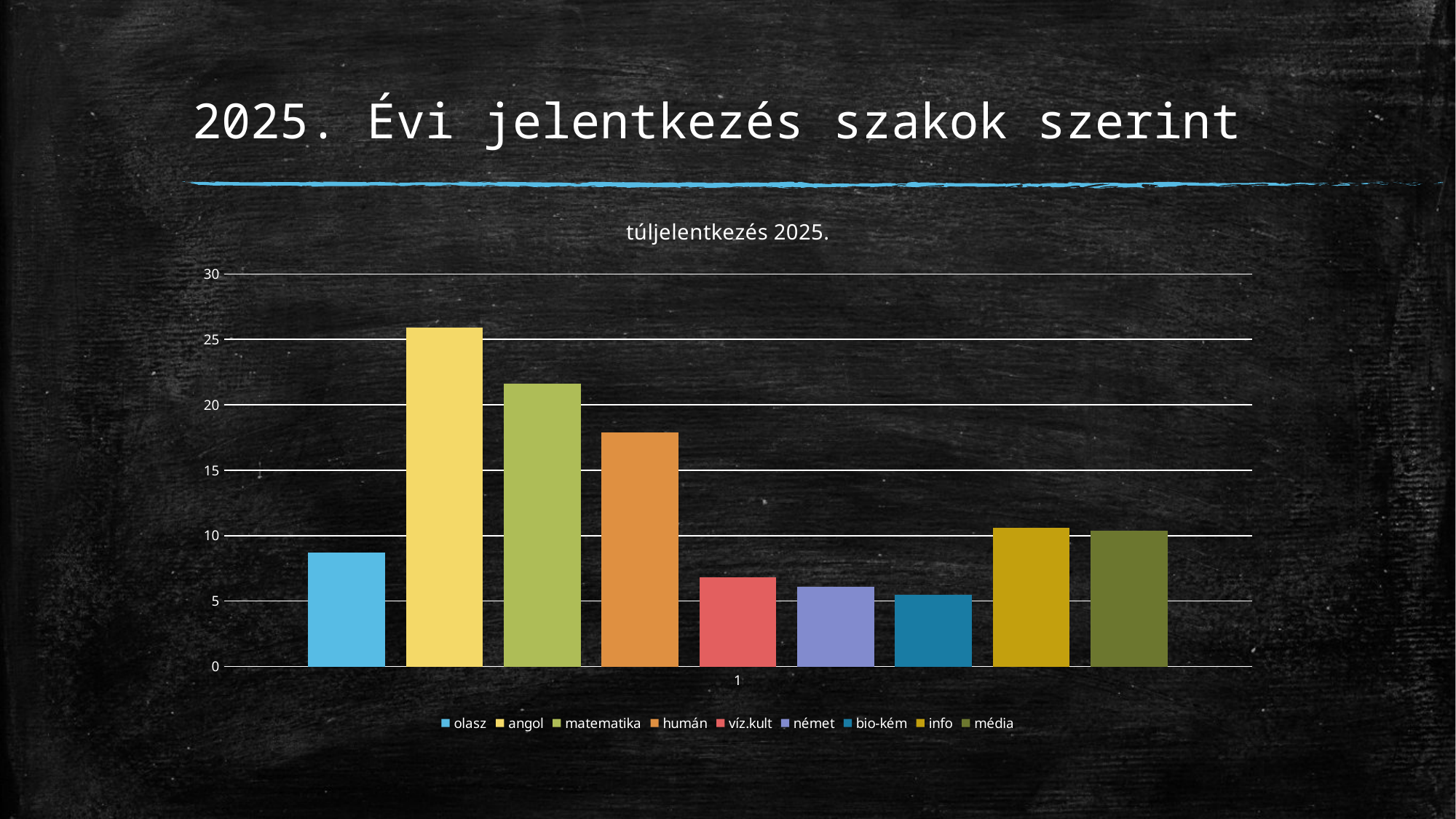
Is the value for matematika greater or less than 20? greater How many series does the legend list? 9 Which is larger, the value for angol or the value for matematika? angol Is the value for angol greater or less than 25? greater Which is larger, the value for humán or the value for olasz? humán Which series has the lowest value? bio-kém Which series has the highest value? angol What kind of chart is shown on the slide? bar chart Is the value for olasz greater or less than 10? less What is the title of the chart? túljelentkezés 2025. Which series is listed first in the legend? olasz